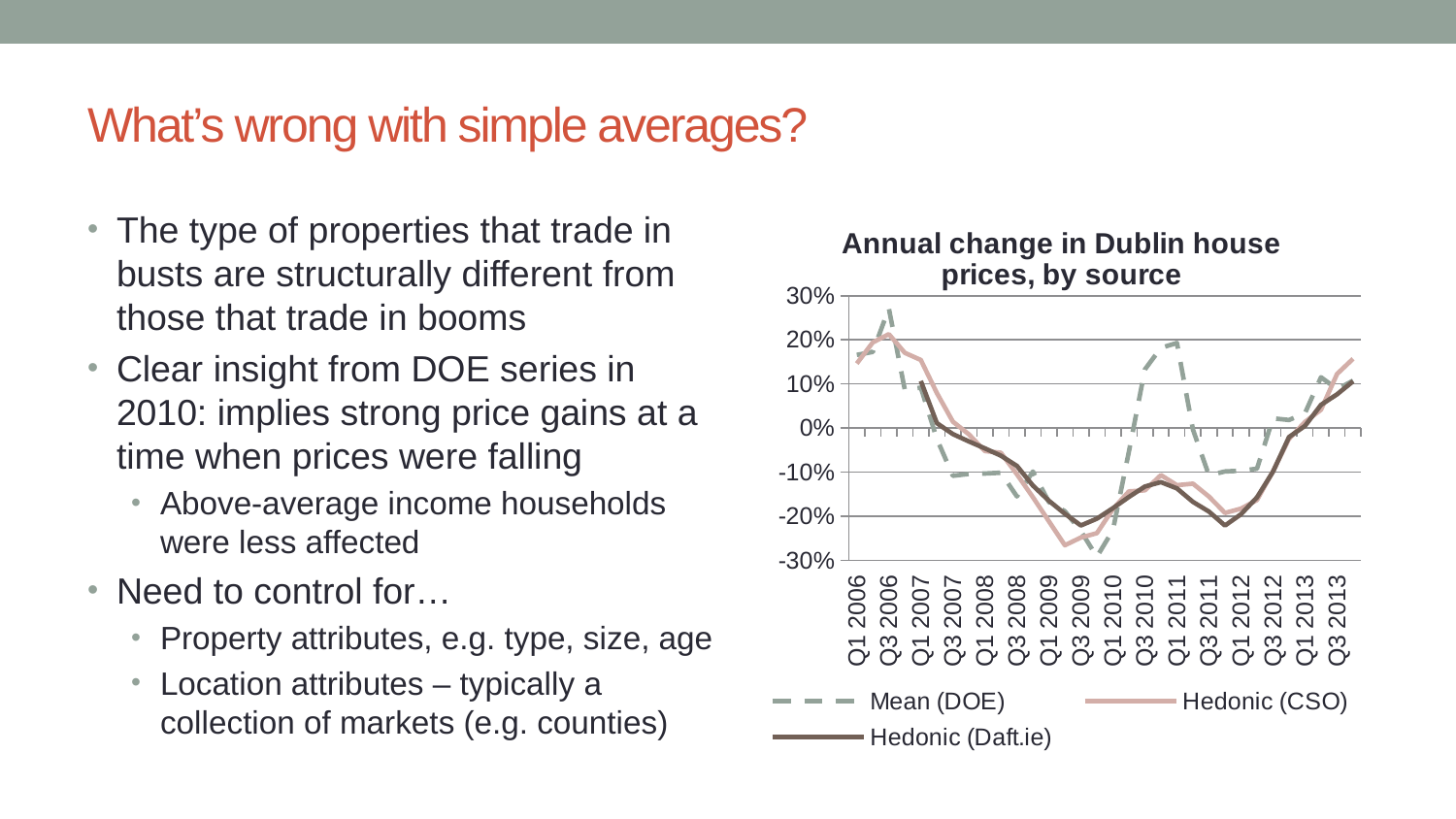
Which series in the chart is drawn with a dashed line? Mean (DOE) Is the value of the Mean (DOE) series at Q3 2006 greater or less than 20%? greater Does the Hedonic (CSO) series rise or fall between Q1 2012 and Q3 2013? Rise At Q1 2011, which series has the higher value: Mean (DOE) or Hedonic (Daft.ie)? Mean (DOE) How many quarter labels are shown along the x axis of the chart? 16 What is the title of the chart? Annual change in Dublin house prices, by source What kind of chart is shown on the slide? Line chart Is the value of the Mean (DOE) series at Q3 2009 greater or less than -20%? less How many series does the chart's legend list? 3 Does the Hedonic (Daft.ie) series rise or fall between Q1 2007 and Q3 2009? Fall Is the value of the Mean (DOE) series at Q1 2011 greater or less than 10%? greater